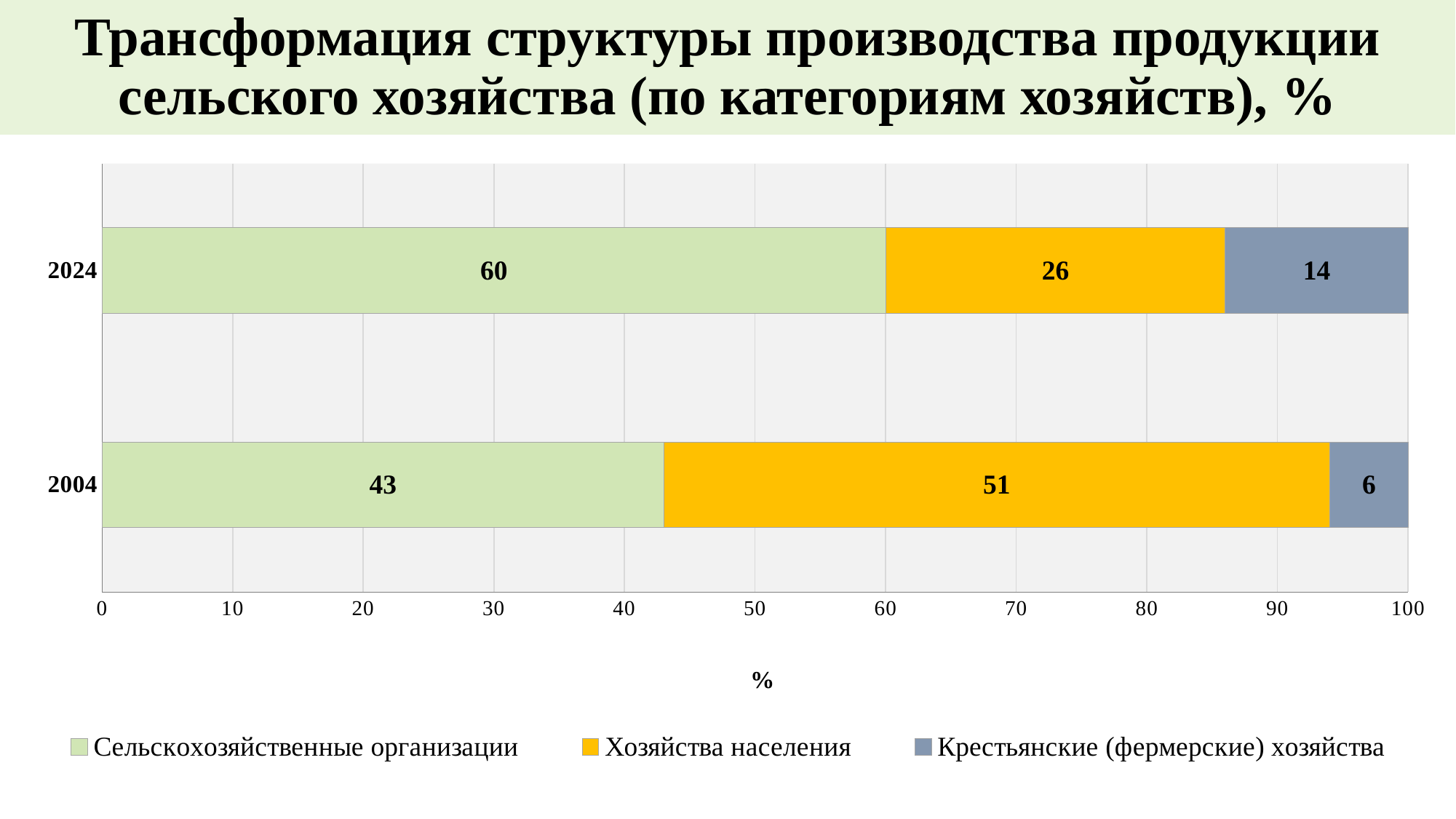
What is the value for Крестьянские (фермерские) хозяйства in 2024? 14 What is the value for Хозяйства населения in 2004? 51 What is the difference between the Сельскохозяйственные организации values for 2024 and 2004? 17 What kind of chart is shown on the slide? Stacked bar chart What is the value for Крестьянские (фермерские) хозяйства in 2004? 6 What is the total of the stacked bar for 2024? 100 Which series has the largest value in 2004? Хозяйства населения Which year has the higher value for Хозяйства населения? 2004 How many years (categories) are shown on the chart? 2 Which series has the smallest value in 2024? Крестьянские (фермерские) хозяйства What is the value for Сельскохозяйственные организации in 2024? 60 How many series does the legend list? 3